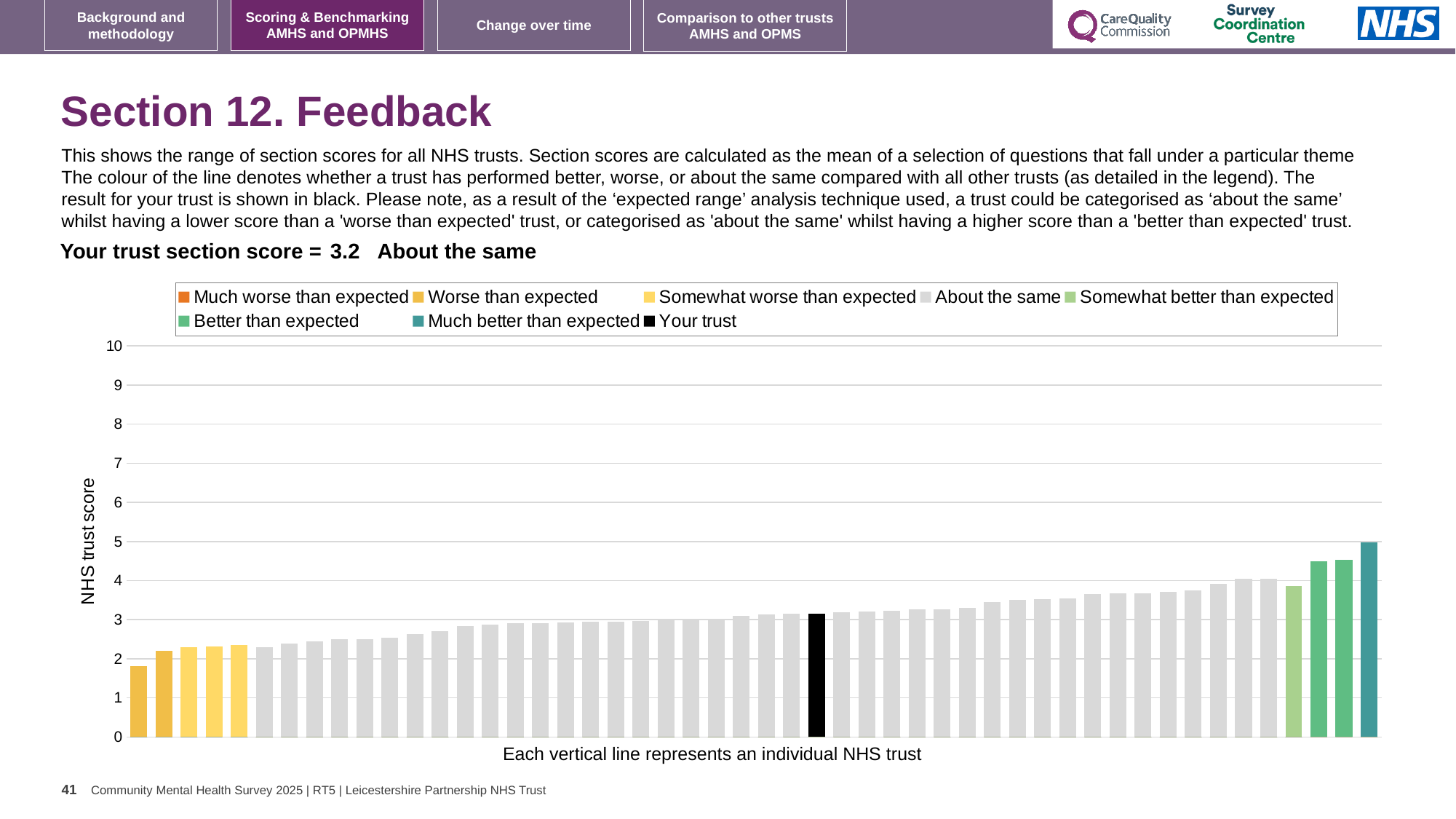
What kind of chart is shown on the slide? bar chart What is the highest value shown on the vertical axis? 10 Do the bar values rise or fall from left to right along the x axis? rise What is the section score for your trust shown on the slide? 3.2 Is the value of the leftmost bar greater or less than 2? less What colour is used for the bar representing your trust? black Is the value of the tallest bar greater or less than 4? greater Is the value of the tallest bar greater or less than 6? less How many entries does the chart legend list? 8 What is the label on the vertical axis of the chart? NHS trust score Which category is your trust's section score placed in? About the same